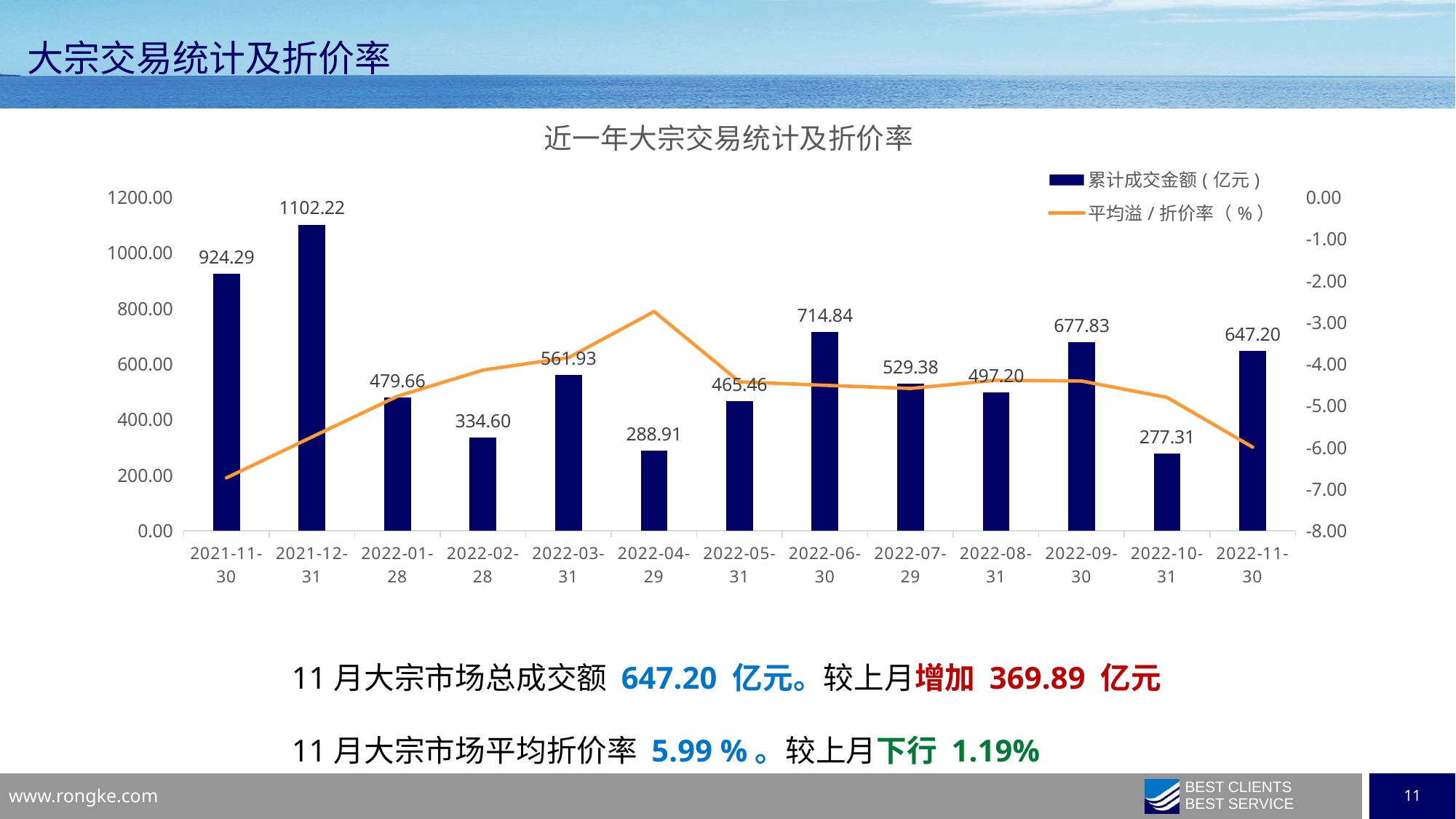
How many series does the chart legend list? 2 Is the 平均溢/折价率 (%) value for 2021-11-30 greater or less than -6.00? less Which month has the highest 累计成交金额 (亿元)? 2021-12-31 What is the 累计成交金额 (亿元) value for 2022-04-29? 288.91 What is the 累计成交金额 (亿元) value for 2021-12-31? 1102.22 What is the 累计成交金额 (亿元) value for 2022-06-30? 714.84 Which month has the lowest 累计成交金额 (亿元)? 2022-10-31 How many months are shown on the x axis of the chart? 13 Does the 平均溢/折价率 (%) line rise or fall from 2022-09-30 to 2022-11-30? fall Which is larger, the 累计成交金额 for 2022-09-30 or for 2022-11-30? 2022-09-30 What is the difference in 累计成交金额 (亿元) between 2022-11-30 and 2022-10-31? 369.89 What kind of chart is shown on the slide? Combined bar and line chart